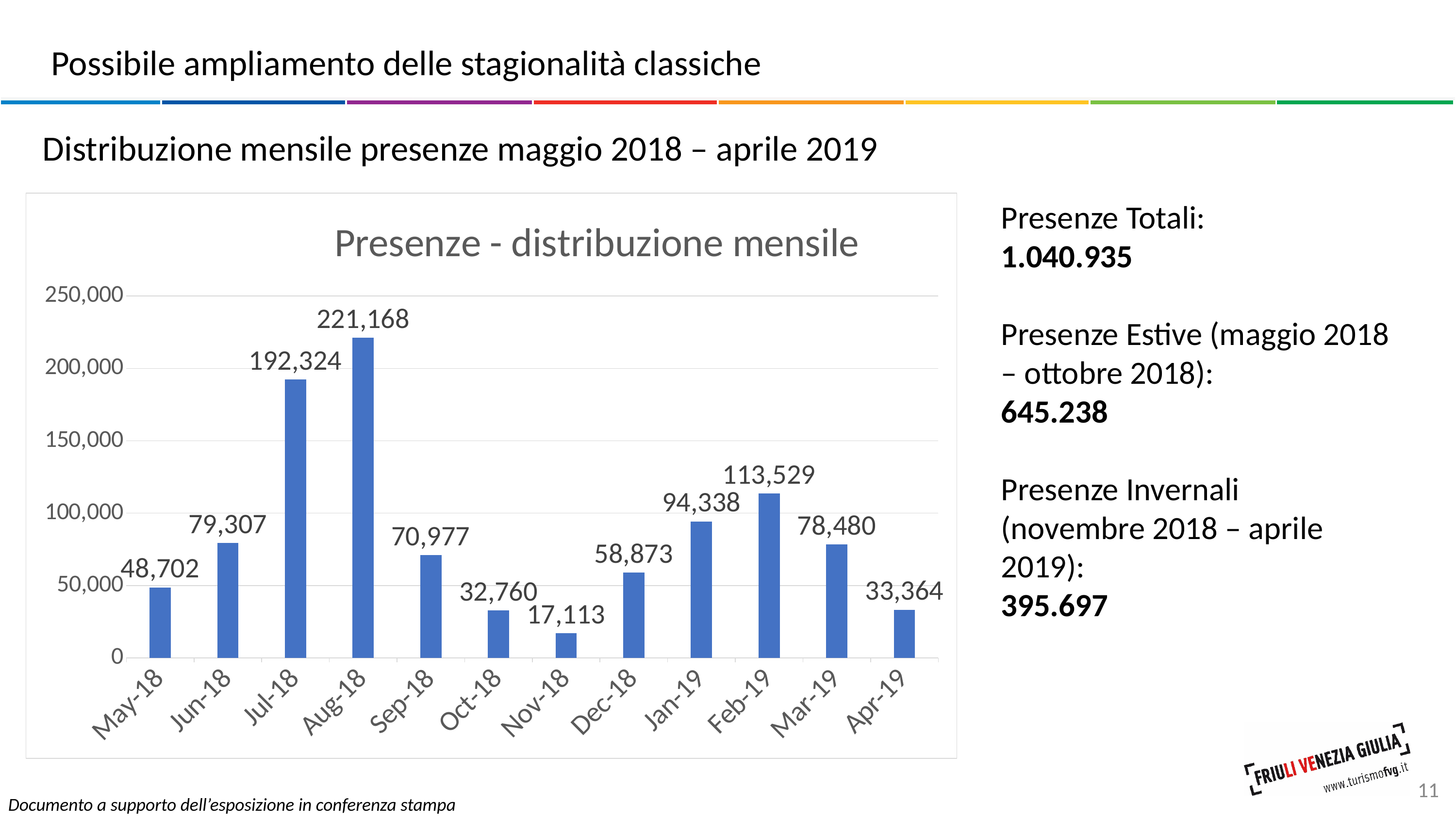
What type of chart is shown on the slide? bar chart What is the value for Feb-19? 113,529 What is the title of the chart? Presenze - distribuzione mensile Do the values rise or fall from Aug-18 to Nov-18? fall What is the value for Aug-18? 221,168 What is the difference between the values for Aug-18 and Jul-18? 28,844 What is the value for Nov-18? 17,113 How many months are shown on the x axis? 12 Is the value for Jul-18 greater or less than 150,000? greater Which month has the lowest value? Nov-18 Which is larger, the value for Sep-18 or the value for Dec-18? Sep-18 Which month has the highest value? Aug-18